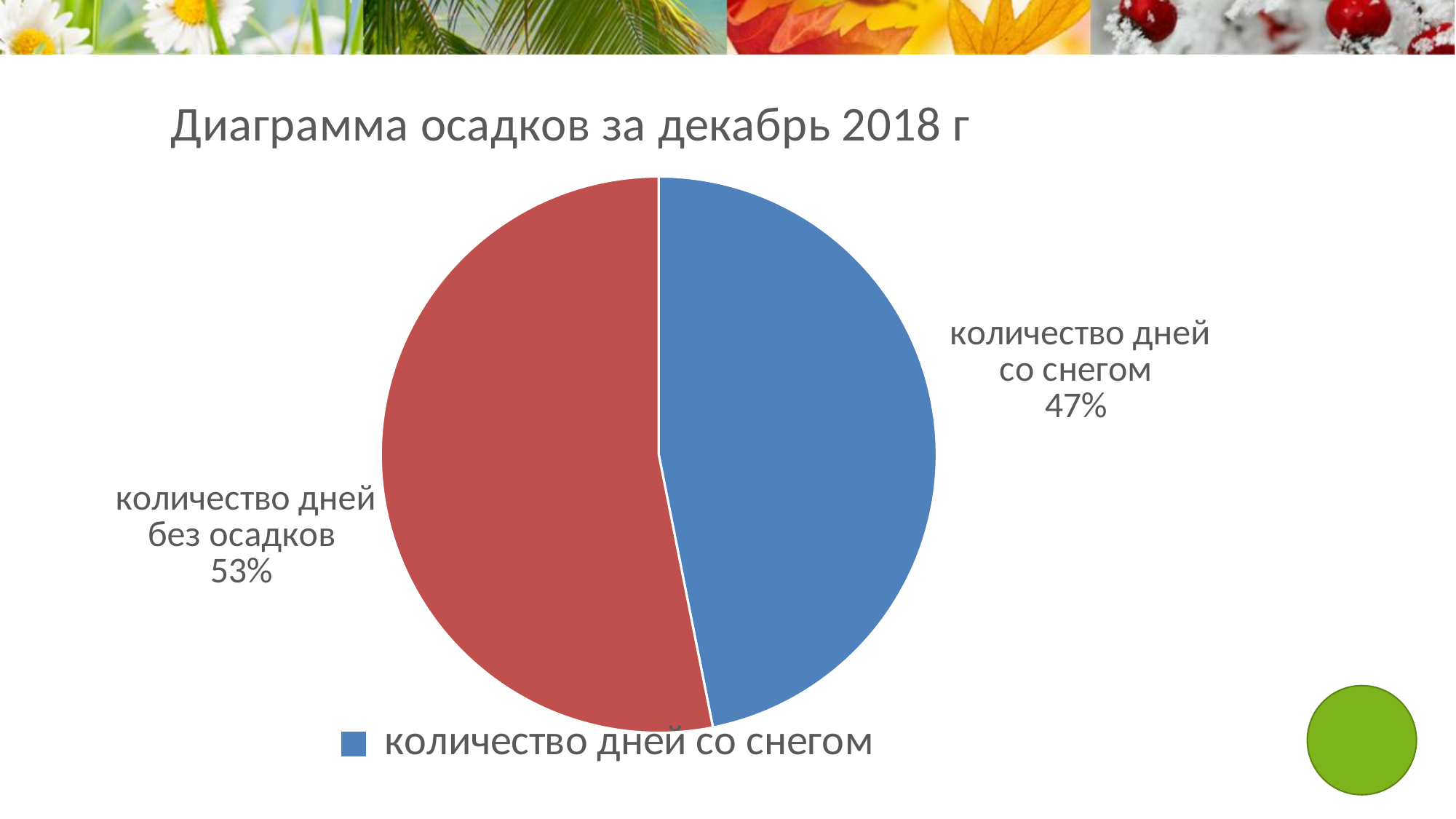
Is the share for "количество дней со снегом" greater or less than 50%? less What is the difference in percentage points between the "количество дней без осадков" slice and the "количество дней со снегом" slice? 6 What kind of chart is shown on the slide? pie chart Which is larger: the share for "количество дней со снегом" or the share for "количество дней без осадков"? количество дней без осадков What share of the pie does "количество дней без осадков" represent? 53% How many slices does the pie chart have? 2 Which slice of the pie is the smallest? количество дней со снегом Which slice of the pie is the largest? количество дней без осадков Is the share for "количество дней без осадков" greater or less than 50%? greater What share of the pie does "количество дней со снегом" represent? 47% What is the title of the chart? Диаграмма осадков за декабрь 2018 г What colour is the slice for "количество дней со снегом"? blue